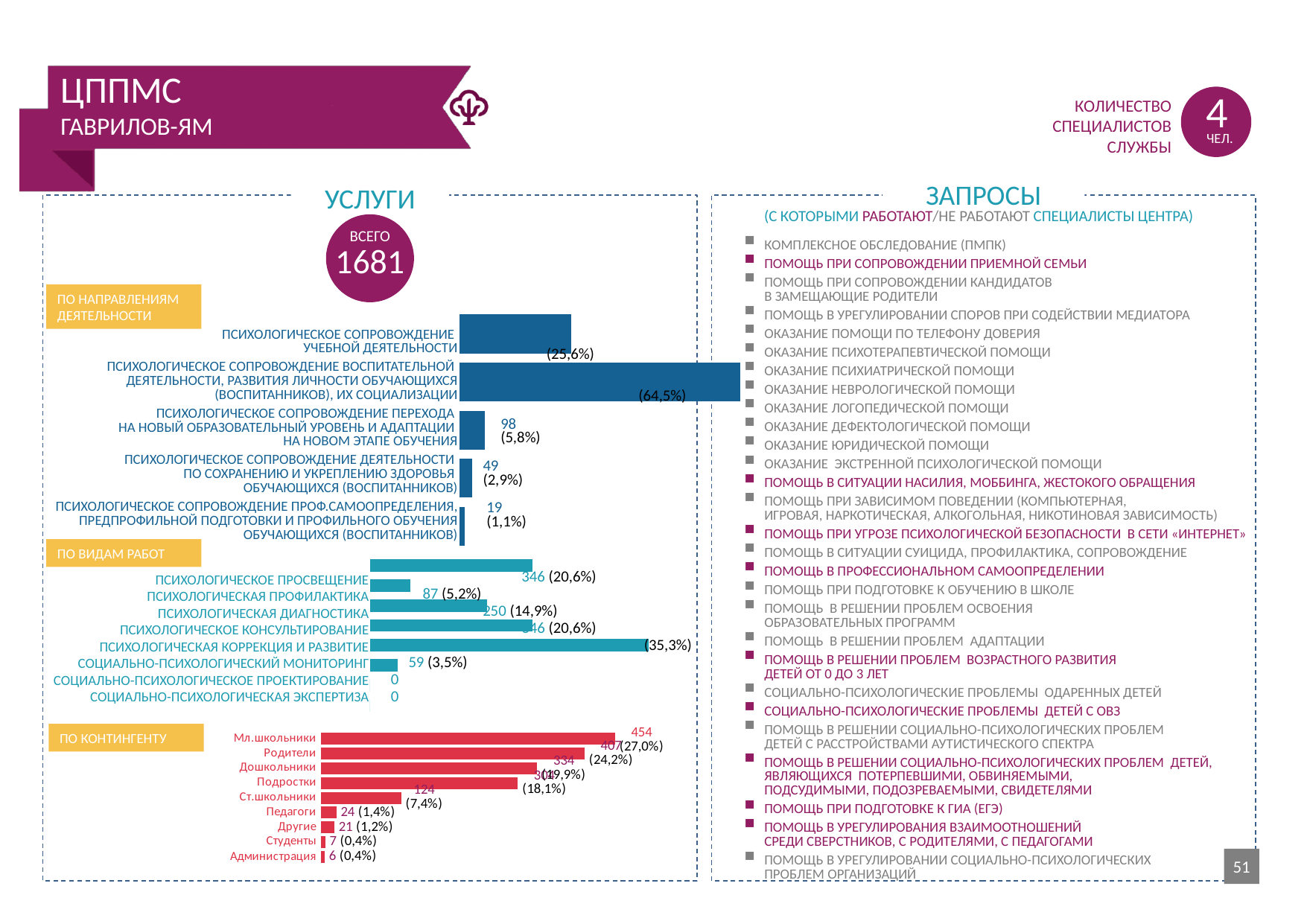
In the 'По видам работ' chart, what value is shown for 'Психологическая диагностика'? 250 (14,9%) In the 'По направлениям деятельности' chart, which direction has the lowest value? Психологическое сопровождение проф.самоопределения, предпрофильной подготовки и профильного обучения обучающихся (воспитанников) In the 'По контингенту' chart, which category has the lowest value? Администрация In the 'По видам работ' chart, how many categories are listed? 8 In the 'По направлениям деятельности' chart, what value is shown for 'Психологическое сопровождение перехода на новый образовательный уровень и адаптации на новом этапе обучения'? 98 (5,8%) In the 'По видам работ' chart, which type of work has the highest value? Психологическая коррекция и развитие In the 'По направлениям деятельности' chart, what percentage is shown for 'Психологическое сопровождение воспитательной деятельности, развития личности обучающихся (воспитанников), их социализации'? 64,5% What type of chart is used in the 'По контингенту' section? Bar chart In the 'По видам работ' chart, which is larger: 'Психологическая профилактика' or 'Социально-психологический мониторинг'? Психологическая профилактика In the 'По контингенту' chart, what value is shown for 'Мл.школьники'? 454 (27,0%) In the 'По направлениям деятельности' chart, what is the difference between the values for 'Психологическое сопровождение перехода...' (98) and 'Психологическое сопровождение деятельности по сохранению и укреплению здоровья...' (49)? 49 In the 'По контингенту' chart, what is the difference between the values for 'Родители' (407) and 'Дошкольники' (334)? 73